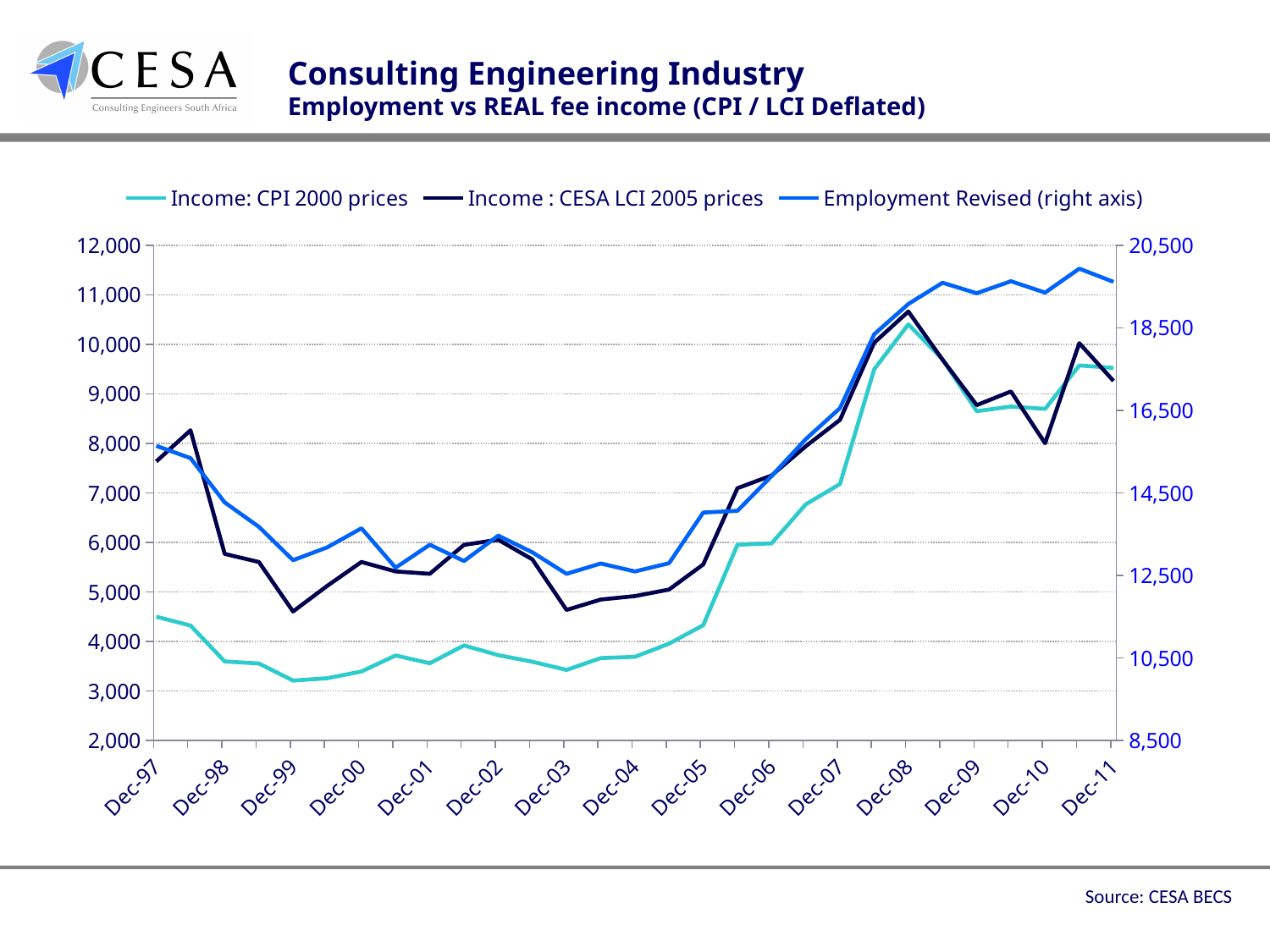
At Dec-97, which is larger: Income : CESA LCI 2005 prices or Income: CPI 2000 prices? Income : CESA LCI 2005 prices Is the value for Employment Revised at Dec-11 greater or less than 18,500 on the right axis? greater How many series does the legend list? 3 Does the Income: CPI 2000 prices series rise or fall between Dec-05 and Dec-08? rise Which series is plotted against the right axis? Employment Revised (right axis) Is the value for Income: CPI 2000 prices at Dec-99 greater or less than 4,000? less How many year labels are shown along the x axis? 15 What kind of chart is shown on the slide? line chart Is the value for Income: CPI 2000 prices at Dec-97 greater or less than 4,000? greater At which date does the Income: CPI 2000 prices series reach its lowest value? Dec-99 At which date does the Income: CPI 2000 prices series reach its highest value? Dec-08